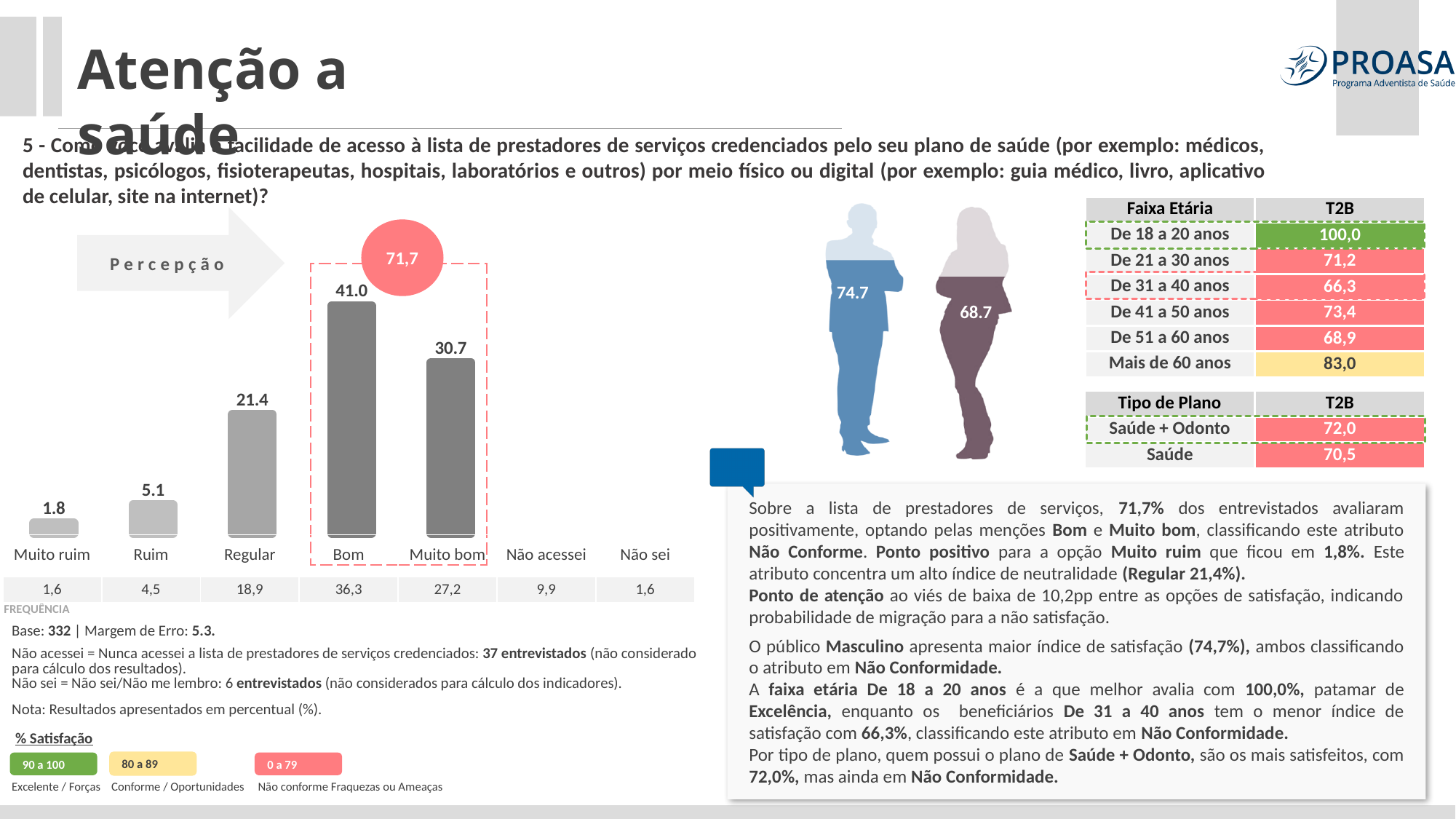
What is the value shown for the Muito bom bar in the bar chart? 30.7 What is the value shown for the Regular bar in the bar chart? 21.4 What is the difference between the Ruim and Muito ruim values in the bar chart? 3.3 What value is shown in the red circle above the dashed box around Bom and Muito bom? 71,7 What is the difference between the Bom and Muito bom values in the bar chart? 10.3 What is the value shown for the Muito ruim bar in the bar chart? 1.8 Which category has the lowest bar in the bar chart? Muito ruim In the bar chart, which is larger: the value for Regular or the value for Muito bom? Muito bom How many bars with values are plotted in the bar chart? 5 Which category has the highest bar in the bar chart? Bom What is the value shown for the Bom bar in the bar chart? 41.0 What kind of chart is used to show the Muito ruim to Muito bom values? bar chart